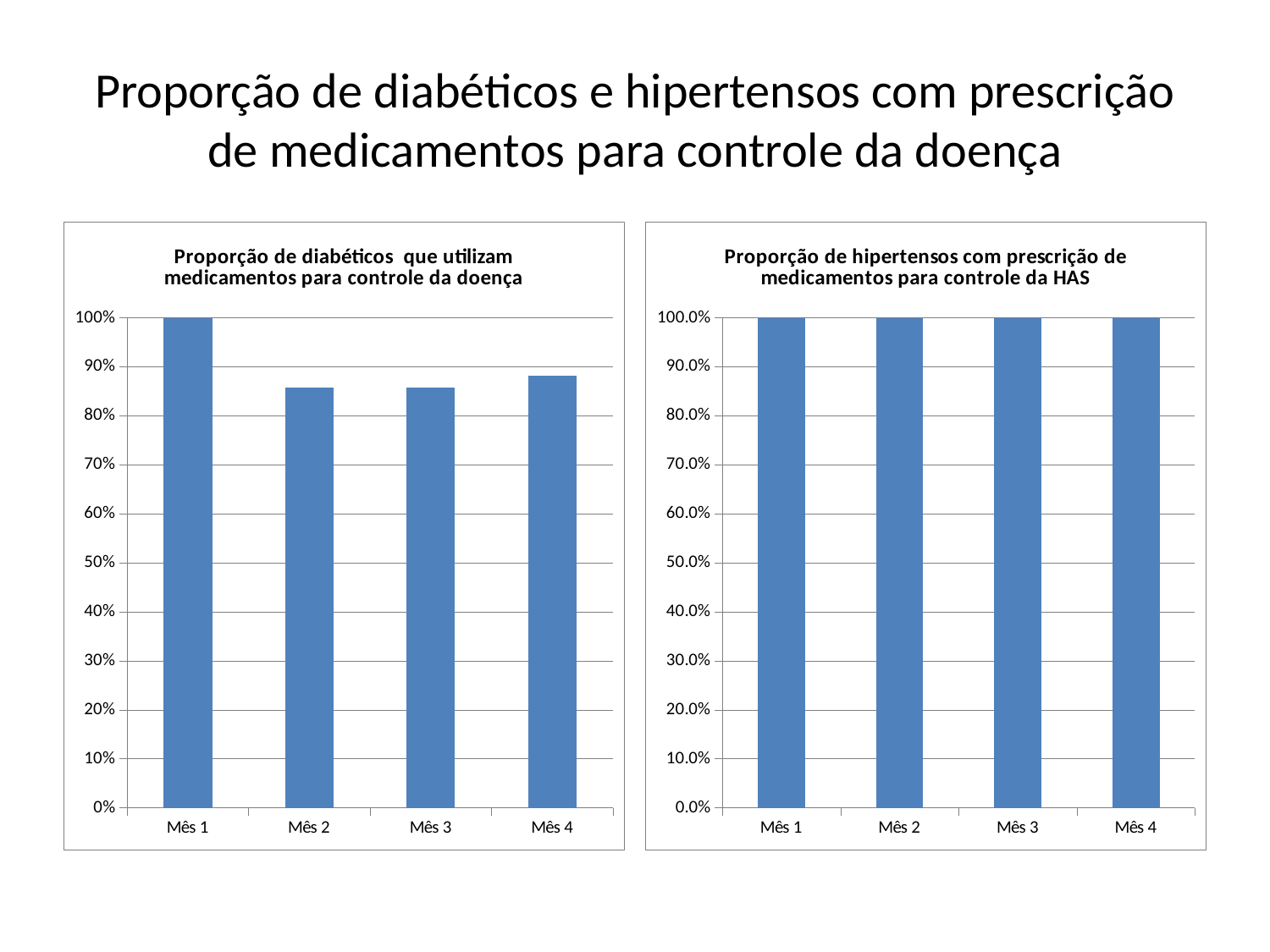
How many bars are in the right chart (Proporção de hipertensos com prescrição de medicamentos para controle da HAS)? 4 In the left chart (Proporção de diabéticos que utilizam medicamentos para controle da doença), is the value for Mês 2 greater or less than 80%? greater In the left chart (Proporção de diabéticos que utilizam medicamentos para controle da doença), is the value for Mês 3 greater or less than 90%? less In the left chart (Proporção de diabéticos que utilizam medicamentos para controle da doença), which month has the highest value? Mês 1 In the right chart (Proporção de hipertensos com prescrição de medicamentos para controle da HAS), do the values rise, fall or stay the same from Mês 1 to Mês 4? stay the same How many charts are on the slide? 2 In the left chart (Proporção de diabéticos que utilizam medicamentos para controle da doença), what is the value for Mês 1? 100% What kind of chart is the left chart (Proporção de diabéticos que utilizam medicamentos para controle da doença)? bar chart In the right chart (Proporção de hipertensos com prescrição de medicamentos para controle da HAS), what is the value for Mês 1? 100.0% In the left chart (Proporção de diabéticos que utilizam medicamentos para controle da doença), which is larger, the value for Mês 1 or the value for Mês 4? Mês 1 In the right chart (Proporção de hipertensos com prescrição de medicamentos para controle da HAS), what is the value for Mês 3? 100.0% How many months are shown on the x axis of the left chart (Proporção de diabéticos que utilizam medicamentos para controle da doença)? 4